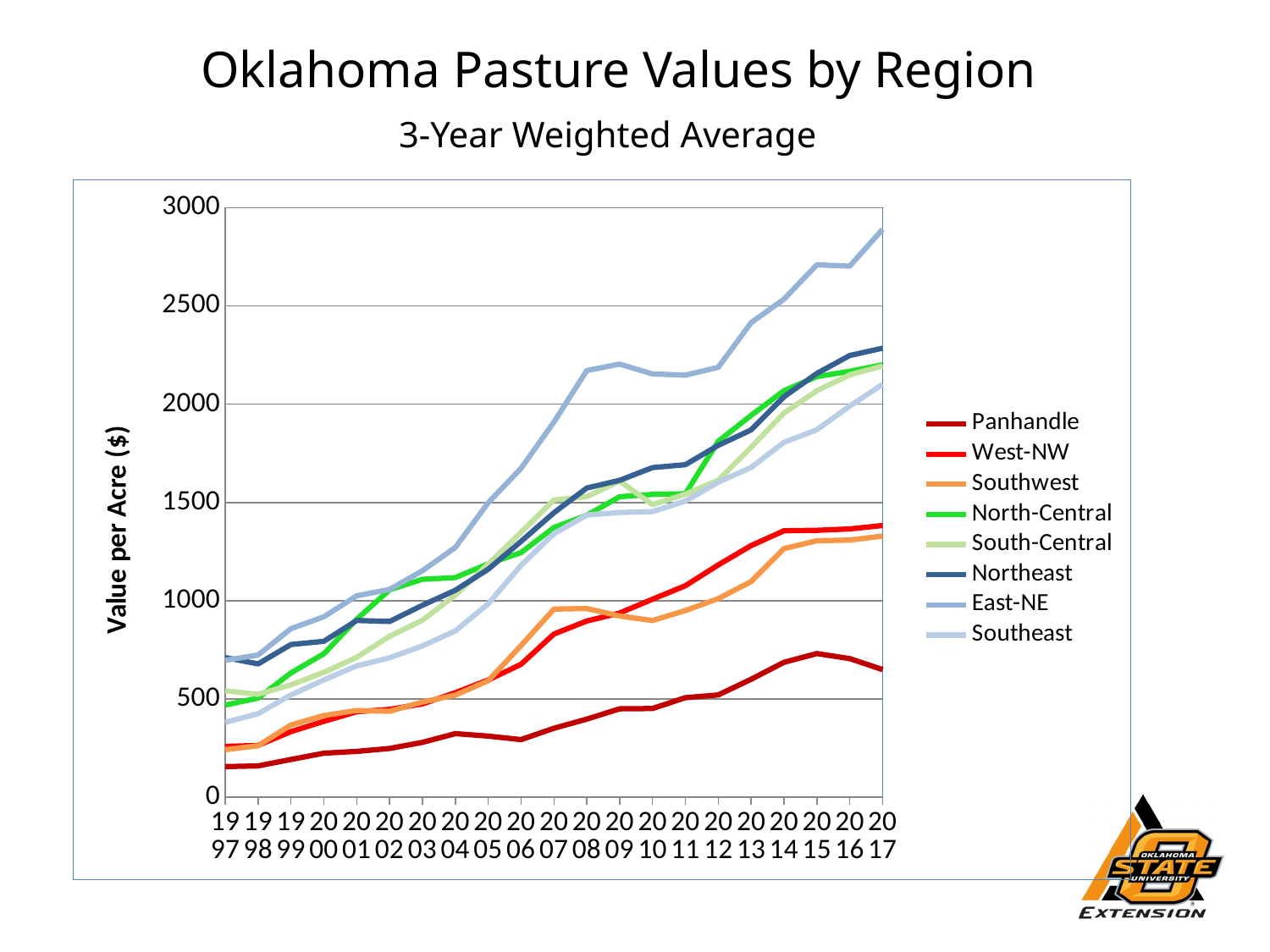
Do the Panhandle values generally rise or fall from 1997 to 2017? rise Is the value for Panhandle in 2017 greater or less than 1000? less How many years are shown along the x axis? 21 Is the value for Southeast in 1997 greater or less than 500? less What is the label on the y axis? Value per Acre ($) Is the value for East-NE in 2017 greater or less than 2500? greater What kind of chart is shown on the slide? line chart How many series does the legend list? 8 Which region has the lowest pasture value in 2017? Panhandle Which region has the highest pasture value in 2017? East-NE Which is larger in 2017, the value for West-NW or the value for North-Central? North-Central